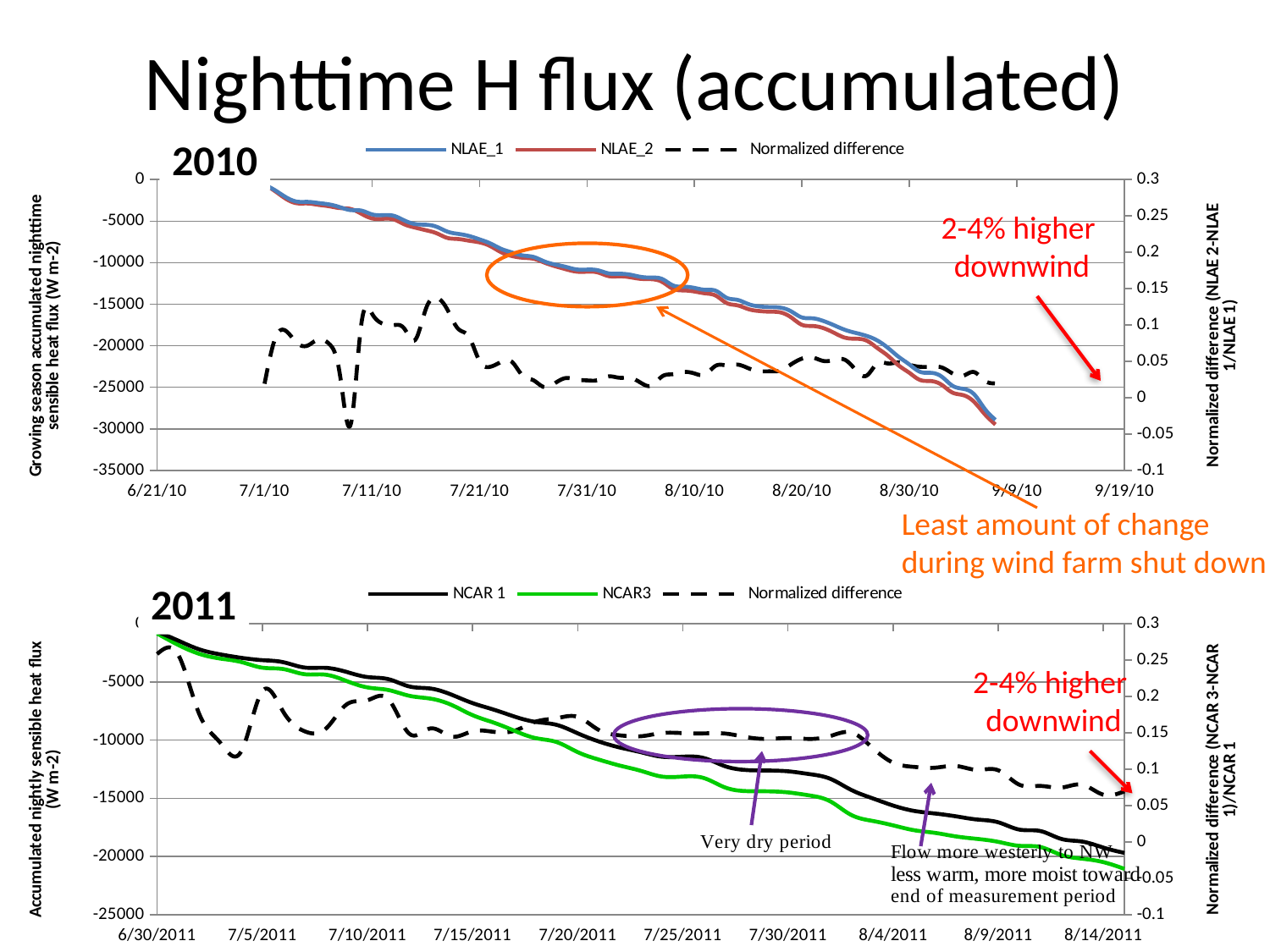
In the 2011 chart, is the value for NCAR3 on 7/30/2011 greater or less than -10000? less In the 2011 chart, is the Normalized difference on 7/25/2011 greater or less than 0.1? greater In the 2010 chart, do the NLAE_1 values rise or fall along the x axis from 7/1/10 to 9/9/10? fall How many series does the legend of the 2010 chart list? 3 What is the maximum value shown on the right-hand axis of the 2011 chart? 0.3 In the 2010 chart, which series is drawn as a dashed black line? Normalized difference In the 2011 chart, do the NCAR3 values rise or fall over the measurement period? fall In the 2011 chart, which series has the higher value on 8/9/2011, NCAR 1 or NCAR3? NCAR 1 How many series does the legend of the 2011 chart list? 3 What type of chart is the 2010 chart at the top of the slide? line chart In the 2010 chart, is the value for NLAE_2 on 7/21/10 greater or less than -10000? greater